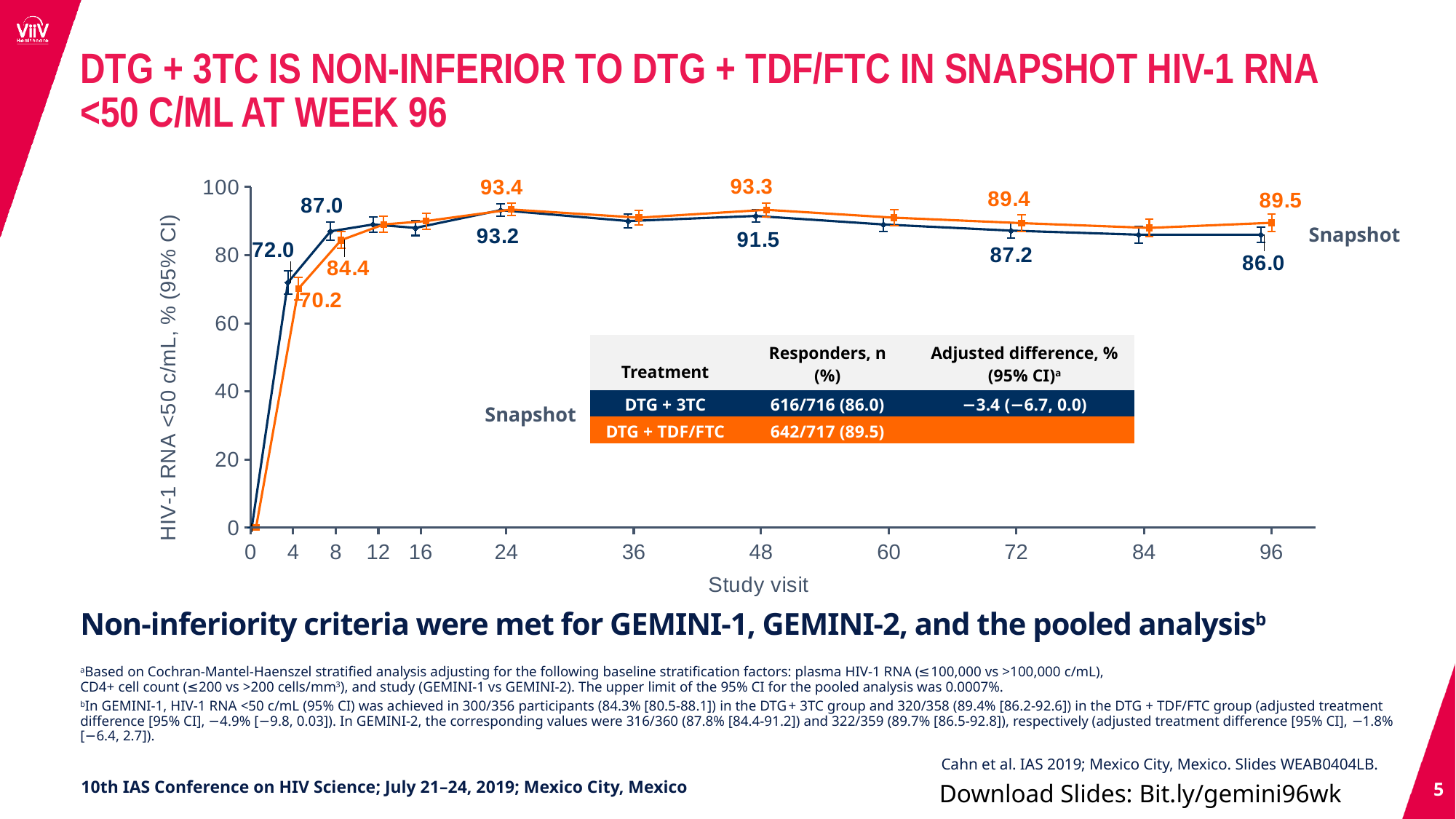
At which study visit does the DTG + TDF/FTC (orange) line reach its highest labelled value? Week 24 At week 48, which treatment has the higher labelled value, DTG + 3TC or DTG + TDF/FTC? DTG + TDF/FTC From week 24 to week 96, does the DTG + 3TC (navy) line rise or fall? fall What is the labelled value for DTG + 3TC (navy line) at study visit week 96? 86.0 What is the label on the y axis of the chart? HIV-1 RNA <50 c/mL, % (95% CI) What is the labelled value for DTG + 3TC (navy line) at week 4? 72.0 What kind of chart is shown on the slide? Line chart What is the difference between the DTG + TDF/FTC and DTG + 3TC labelled values at week 96? 3.5 How many study visit time points are marked on the x axis? 12 What is the labelled value for DTG + TDF/FTC (orange line) at week 8? 84.4 What is the labelled value for DTG + TDF/FTC (orange line) at study visit week 96? 89.5 Is the value for DTG + 3TC (navy line) at week 60 greater or less than 80? greater